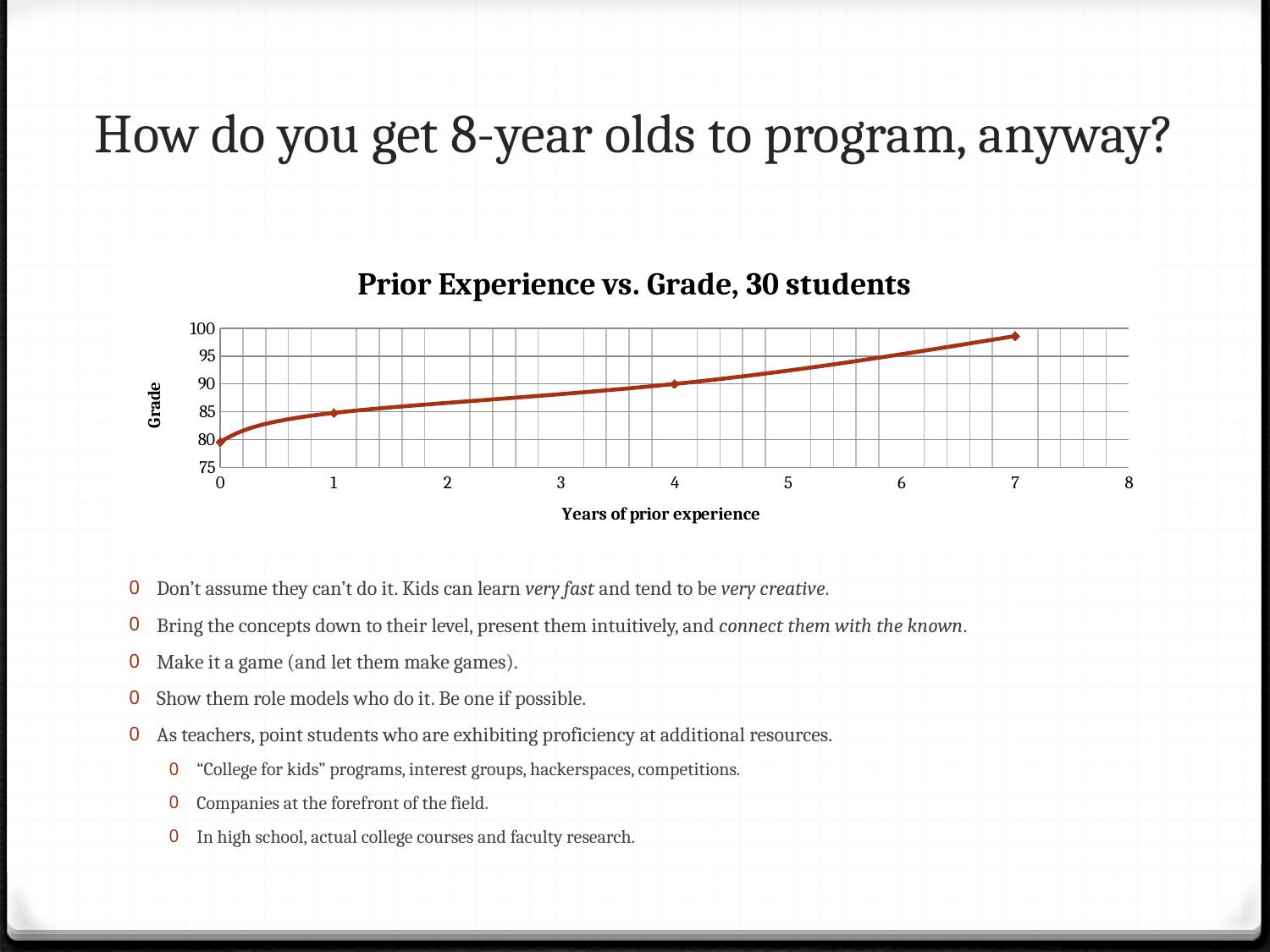
What kind of chart is shown on the slide? line chart Is the grade at 7 years of prior experience greater or less than 95? greater Is the grade at 0 years of prior experience greater or less than 85? less Is the grade at 4 years of prior experience greater or less than 85? greater How many data points are plotted on the chart? 4 Which has the larger grade: 7 years of prior experience or 1 year of prior experience? 7 years Does the grade rise or fall as years of prior experience increase? rise What is the title of the chart? Prior Experience vs. Grade, 30 students At which number of years of prior experience is the grade lowest? 0 At which number of years of prior experience is the grade highest? 7 What is the label of the x axis? Years of prior experience